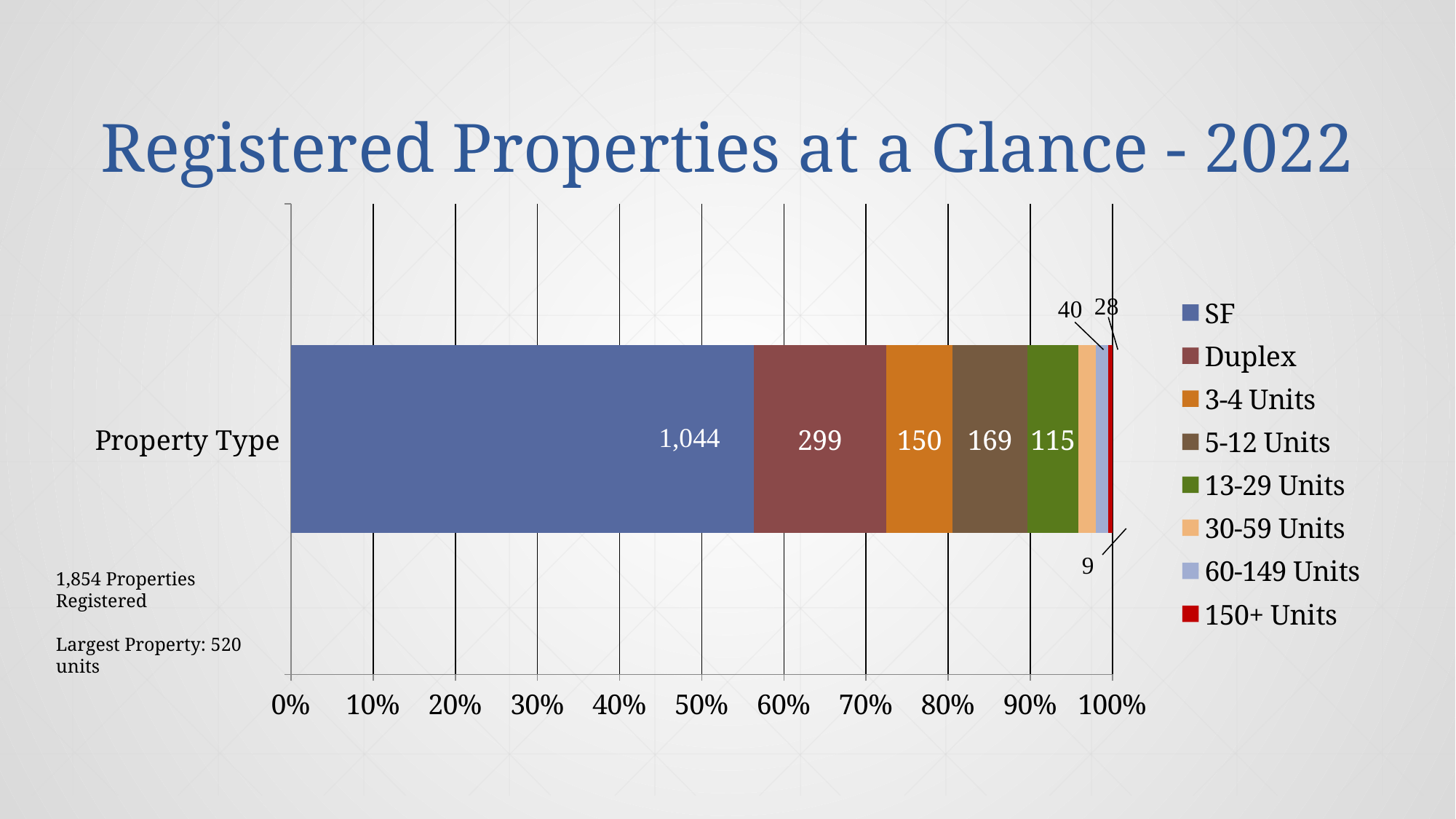
What is the difference between the Duplex value and the 3-4 Units value? 149 Which is larger, the value for 5-12 Units or the value for 13-29 Units? 5-12 Units What is the total of the Property Type stacked bar? 1,854 What is the title of the slide containing the chart? Registered Properties at a Glance - 2022 What is the value for 150+ Units in the Property Type bar? 9 What is the value for 5-12 Units in the Property Type bar? 169 What is the value for SF in the Property Type bar? 1,044 How many series does the legend list? 8 Which series has the largest value in the Property Type bar? SF What is the value for Duplex in the Property Type bar? 299 Which series has the smallest value in the Property Type bar? 150+ Units What kind of chart is shown on the slide? Stacked bar chart